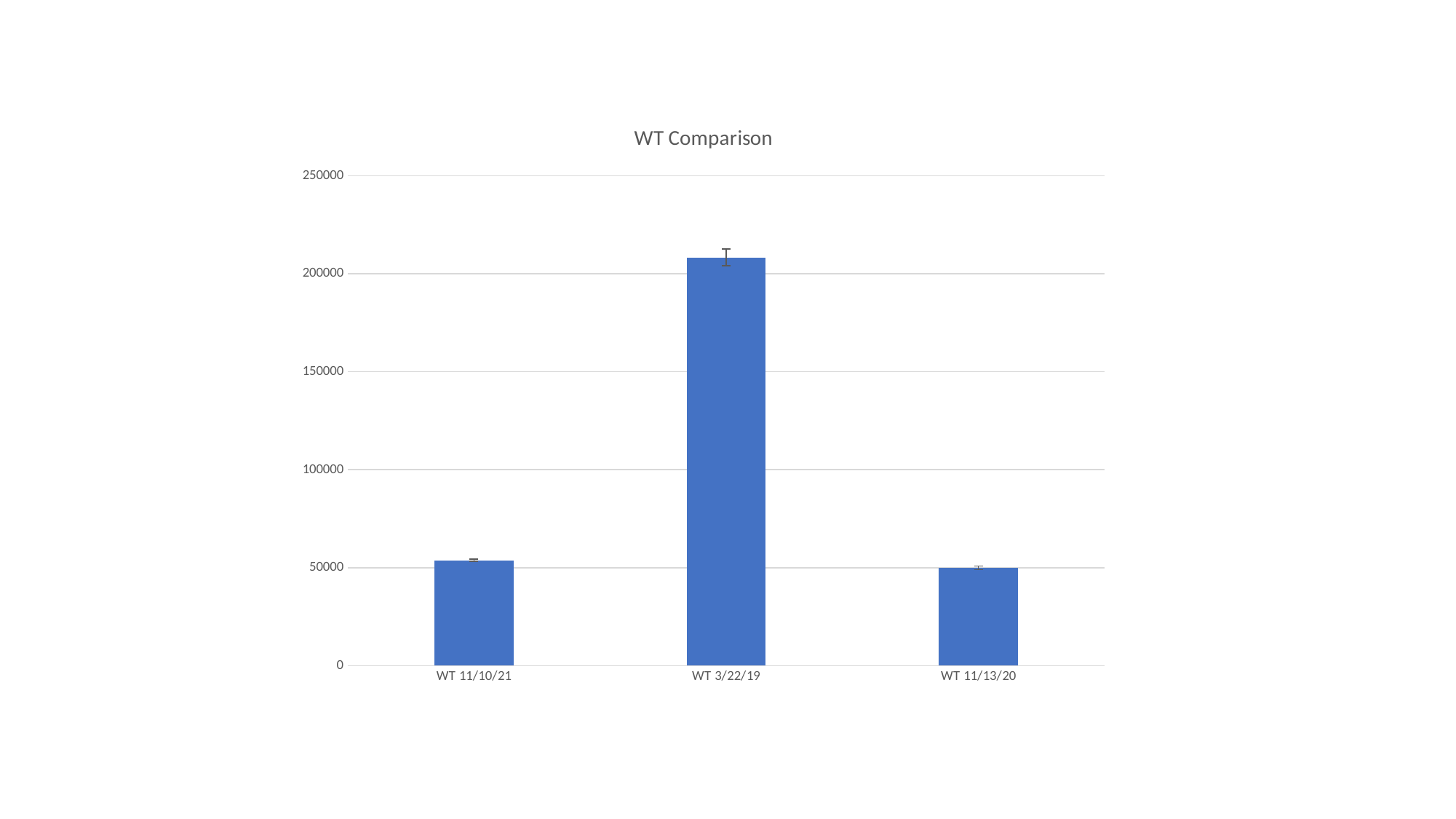
How many bars are plotted in the chart? 3 Is the value for WT 11/13/20 greater or less than 100000? less Is the value for WT 3/22/19 greater or less than 250000? less Which is larger, the value for WT 3/22/19 or the value for WT 11/13/20? WT 3/22/19 What kind of chart is shown on the slide? bar chart What is the title of the chart? WT Comparison Is the value for WT 3/22/19 greater or less than 200000? greater Which is larger, the value for WT 11/10/21 or the value for WT 3/22/19? WT 3/22/19 What is the highest value shown on the vertical axis? 250000 Which category has the highest value? WT 3/22/19